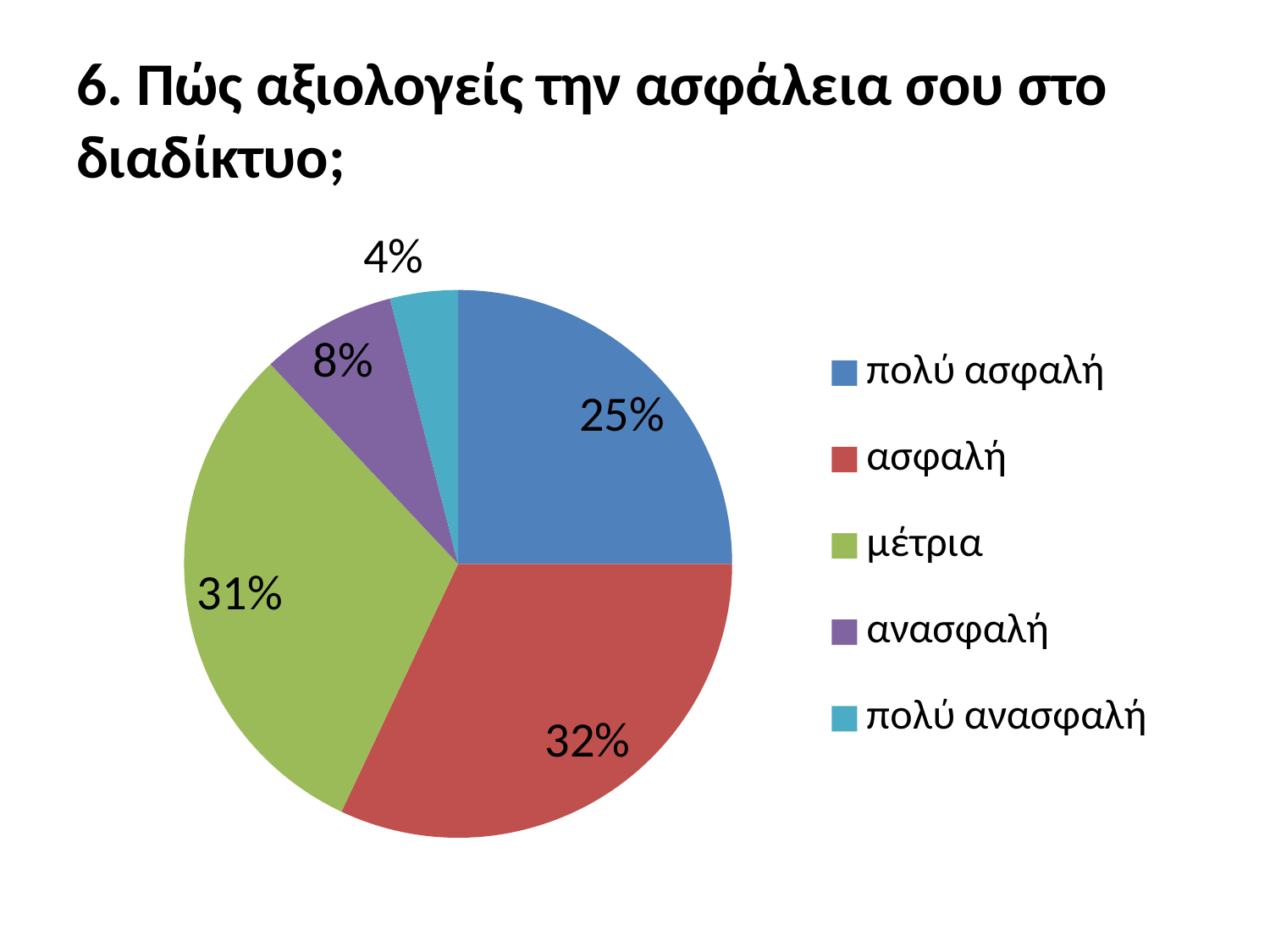
What is the difference in percentage points between "πολύ ασφαλή" and "ανασφαλή"? 17 What percentage is shown for the "ανασφαλή" slice? 8% What percentage of the pie is labelled for "πολύ ασφαλή"? 25% What colour is the "μέτρια" slice in the pie chart? green What type of chart is shown on the slide? pie chart What percentage is shown for the "πολύ ανασφαλή" slice? 4% What percentage is shown for the "μέτρια" slice? 31% Which category has the smallest share of the pie? πολύ ανασφαλή What percentage is shown for the "ασφαλή" slice? 32% How many slices does the pie chart have? 5 Which category has the largest share of the pie? ασφαλή Which is larger, the share for "πολύ ασφαλή" or the share for "μέτρια"? μέτρια